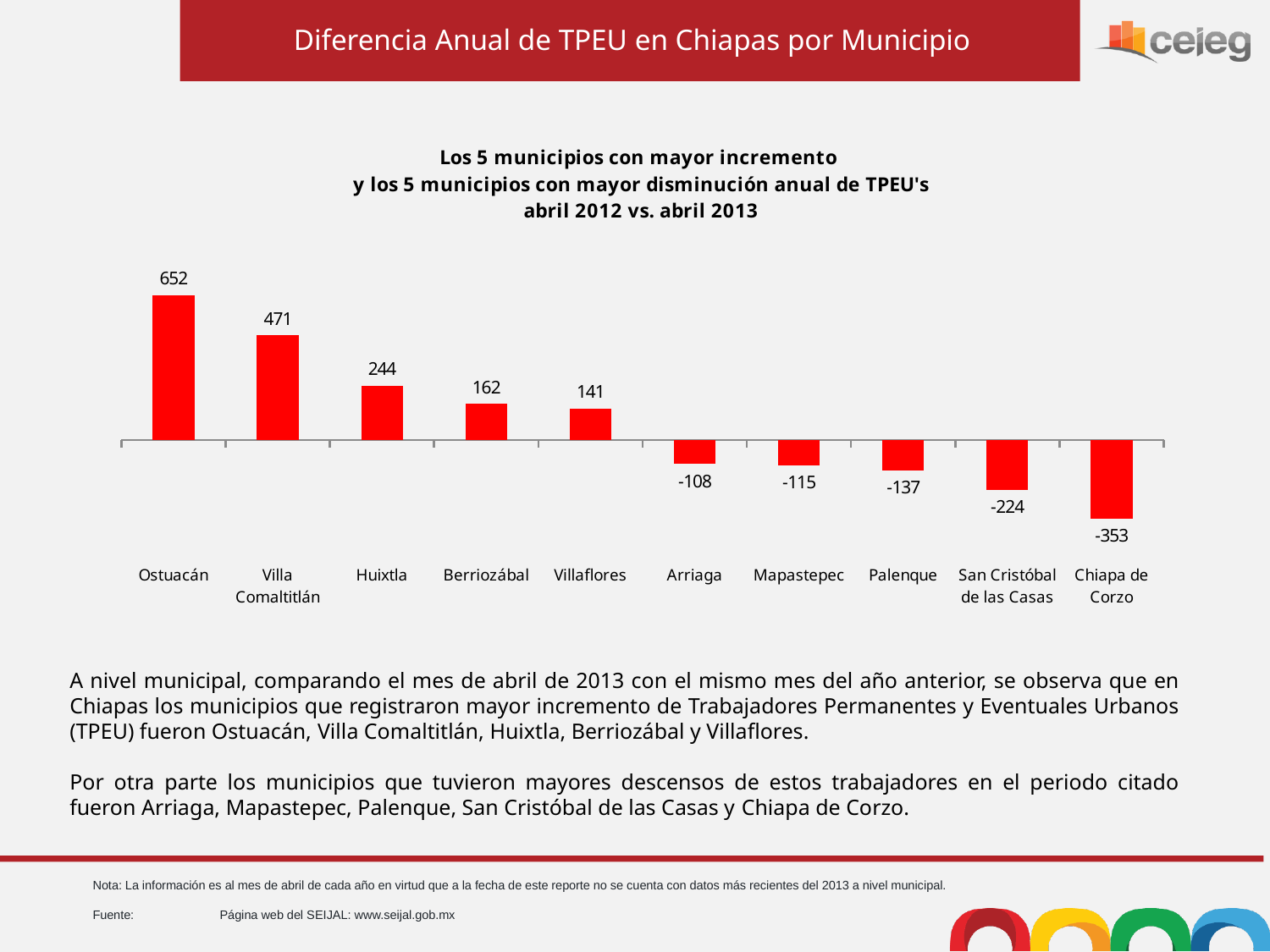
What is the difference between the values for Berriozábal and Villaflores? 21 What is the difference between the values for Ostuacán and Villa Comaltitlán? 181 Which is larger, the value for Arriaga or the value for Mapastepec? Arriaga Which municipality has the highest value? Ostuacán Do the values rise or fall from left to right across the x axis? Fall How many municipalities are shown in the chart? 10 Which municipality has the lowest value? Chiapa de Corzo What is the value for San Cristóbal de las Casas? -224 What is the value for Huixtla? 244 What is the value for Ostuacán? 652 What is the value for Chiapa de Corzo? -353 What kind of chart is shown on the slide? Bar chart